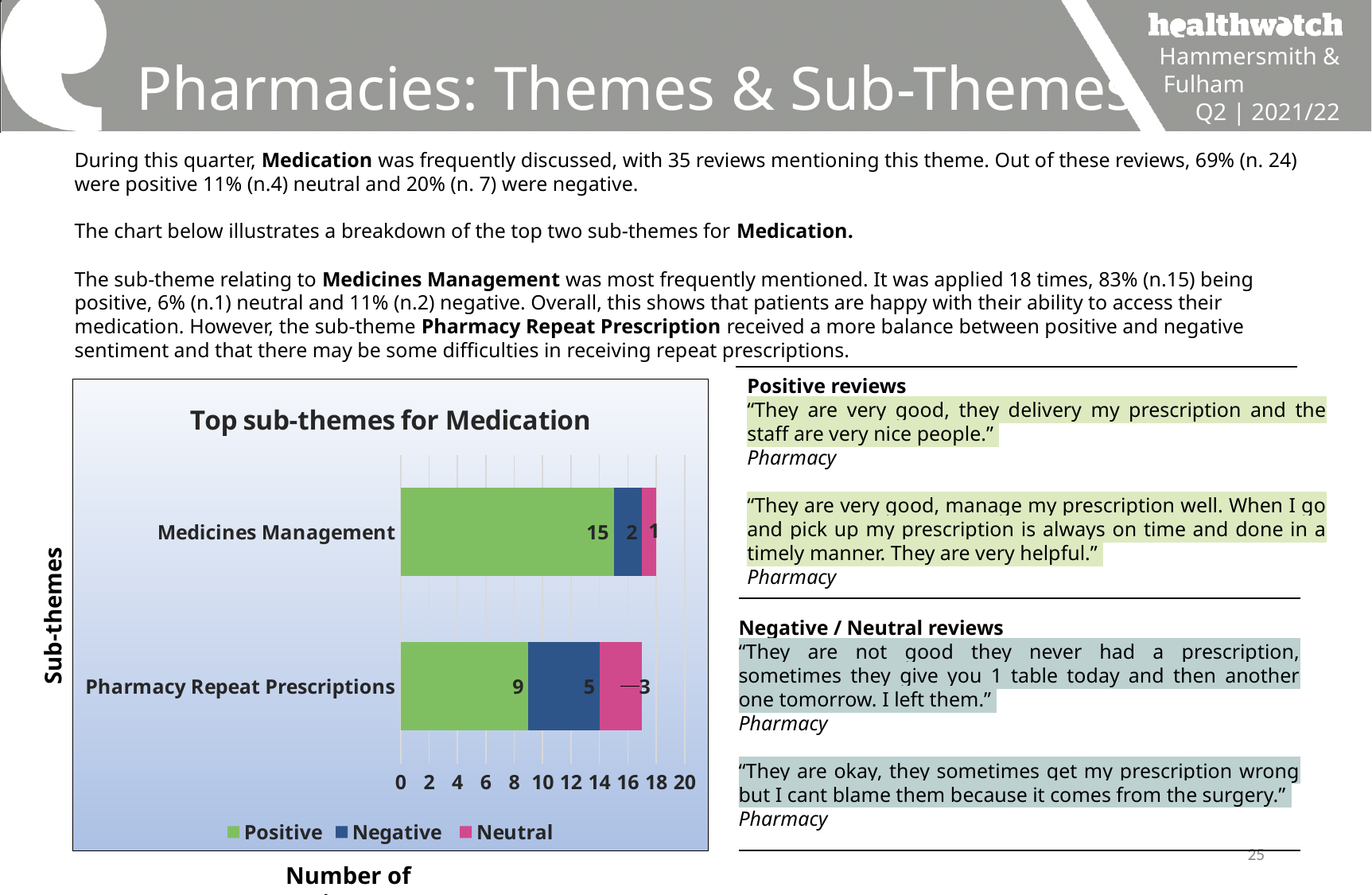
Which sub-theme has the lower Neutral value? Medicines Management What is the Neutral value for Medicines Management? 1 What kind of chart is shown on the slide? Stacked bar chart What is the total of the stacked bar for Pharmacy Repeat Prescriptions? 17 Is the Negative value larger for Medicines Management or for Pharmacy Repeat Prescriptions? Pharmacy Repeat Prescriptions What is the Positive value for Medicines Management in the Top sub-themes for Medication chart? 15 What is the total of the stacked bar for Medicines Management? 18 How many series does the legend of the chart list? 3 Which sub-theme has the higher Positive value? Medicines Management What is the difference between the Positive values for Medicines Management and Pharmacy Repeat Prescriptions? 6 What is the Negative value for Pharmacy Repeat Prescriptions? 5 What is the Positive value for Pharmacy Repeat Prescriptions? 9